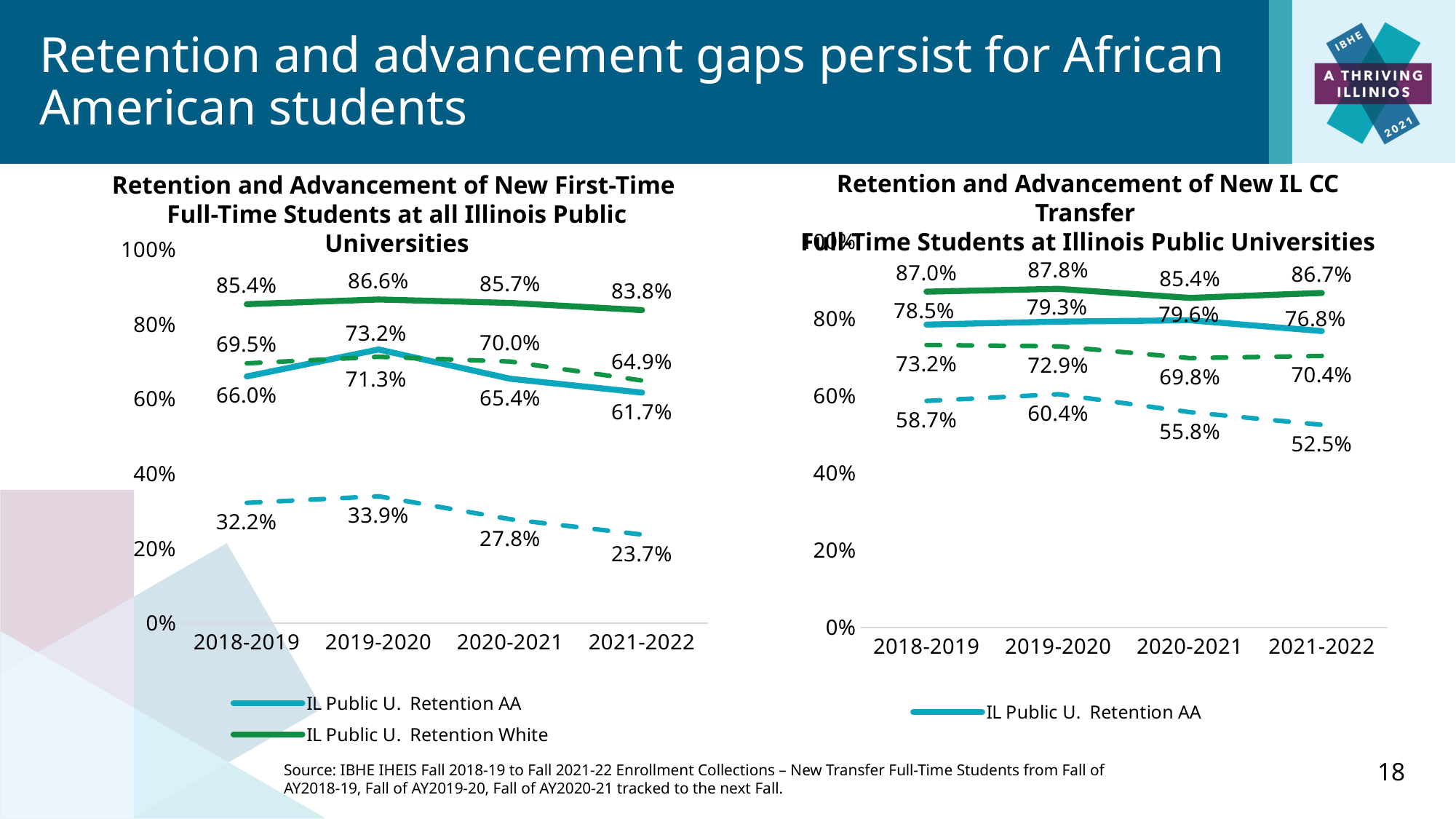
In the left chart (New First-Time Full-Time Students), how many series does the legend list? 2 In the right chart (New IL CC Transfer Full-Time Students), in which year is IL Public U. Retention AA lowest? 2021-2022 In the left chart (New First-Time Full-Time Students), in which year is IL Public U. Retention White lowest? 2021-2022 In the right chart (New IL CC Transfer Full-Time Students), what is the IL Public U. Retention AA value for 2020-2021? 79.6% In the left chart (New First-Time Full-Time Students), how many academic years are shown on the x axis? 4 Which is larger: IL Public U. Retention AA in 2018-2019 in the left chart or in the right chart? Right chart (78.5%) In the left chart (New First-Time Full-Time Students), what is the difference between IL Public U. Retention White and IL Public U. Retention AA in 2021-2022? 22.1% In the left chart (New First-Time Full-Time Students), what is the IL Public U. Retention AA value for 2019-2020? 73.2% In the left chart (New First-Time Full-Time Students), in which year is IL Public U. Retention AA highest? 2019-2020 In the left chart (New First-Time Full-Time Students), what is the IL Public U. Retention White value for 2021-2022? 83.8% In the right chart (New IL CC Transfer Full-Time Students), is the IL Public U. Retention AA value for 2021-2022 greater or less than 80%? less What kind of chart is the right chart (New IL CC Transfer Full-Time Students)? Line chart